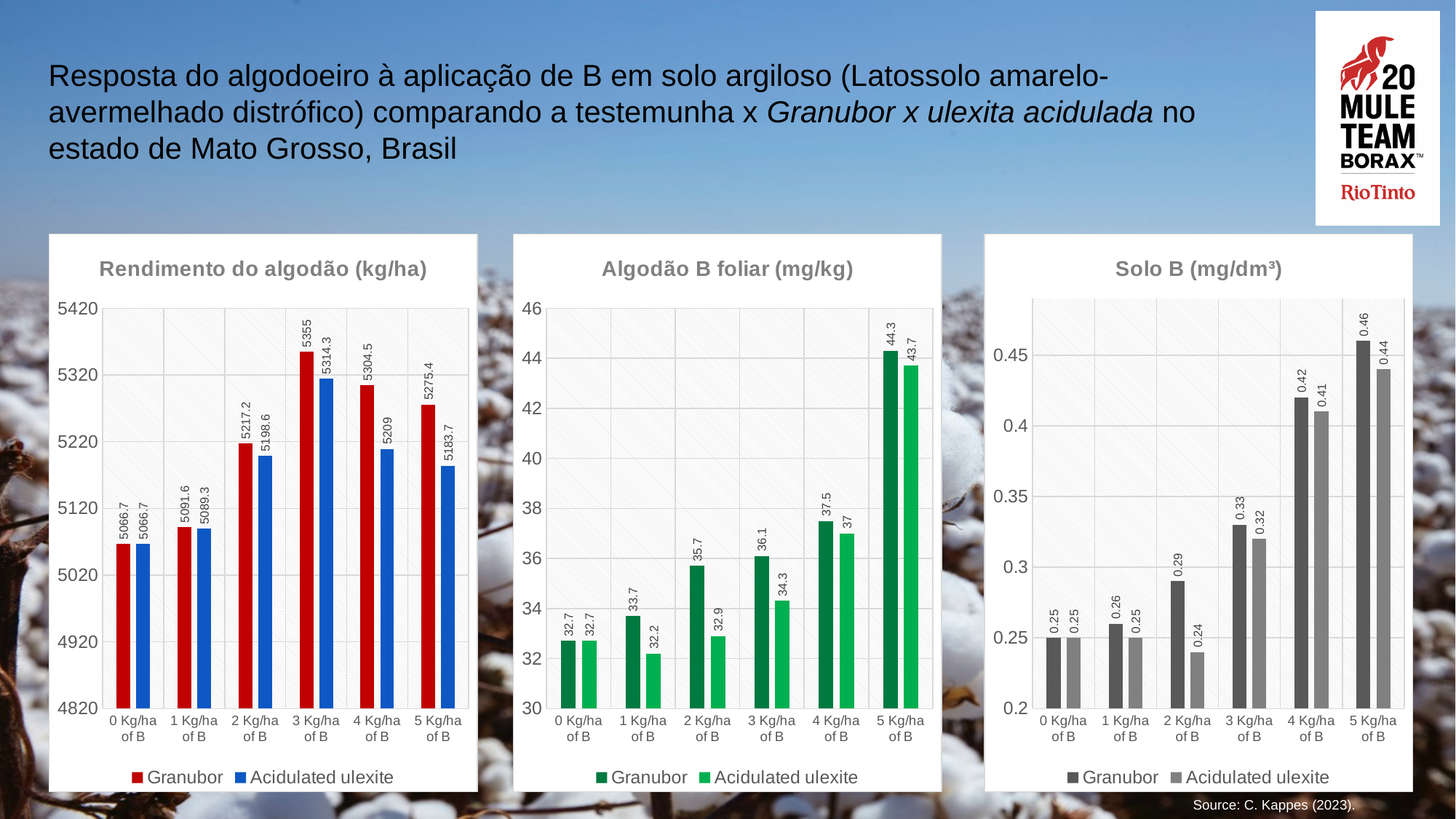
In the 'Rendimento do algodão (kg/ha)' chart, what is the Acidulated ulexite value at 4 Kg/ha of B? 5209 In the 'Algodão B foliar (mg/kg)' chart, which is larger at 2 Kg/ha of B: Granubor or Acidulated ulexite? Granubor How many categories are shown on the x axis of the 'Solo B (mg/dm³)' chart? 6 In the 'Solo B (mg/dm³)' chart, what is the difference between the Granubor and Acidulated ulexite values at 2 Kg/ha of B? 0.05 In the 'Rendimento do algodão (kg/ha)' chart, what is the difference between the Granubor and Acidulated ulexite values at 5 Kg/ha of B? 91.7 In the 'Algodão B foliar (mg/kg)' chart, do the Granubor values rise or fall as the B rate increases from 0 to 5 Kg/ha? rise In the 'Algodão B foliar (mg/kg)' chart, at which B rate is the Acidulated ulexite value lowest? 1 Kg/ha of B How many series does the legend of the 'Rendimento do algodão (kg/ha)' chart list? 2 In the 'Algodão B foliar (mg/kg)' chart, what is the Acidulated ulexite value at 1 Kg/ha of B? 32.2 In the 'Rendimento do algodão (kg/ha)' chart, at which B rate is the Granubor value highest? 3 Kg/ha of B In the 'Rendimento do algodão (kg/ha)' chart, what is the Granubor value at 3 Kg/ha of B? 5355 In the 'Solo B (mg/dm³)' chart, what is the Granubor value at 4 Kg/ha of B? 0.42